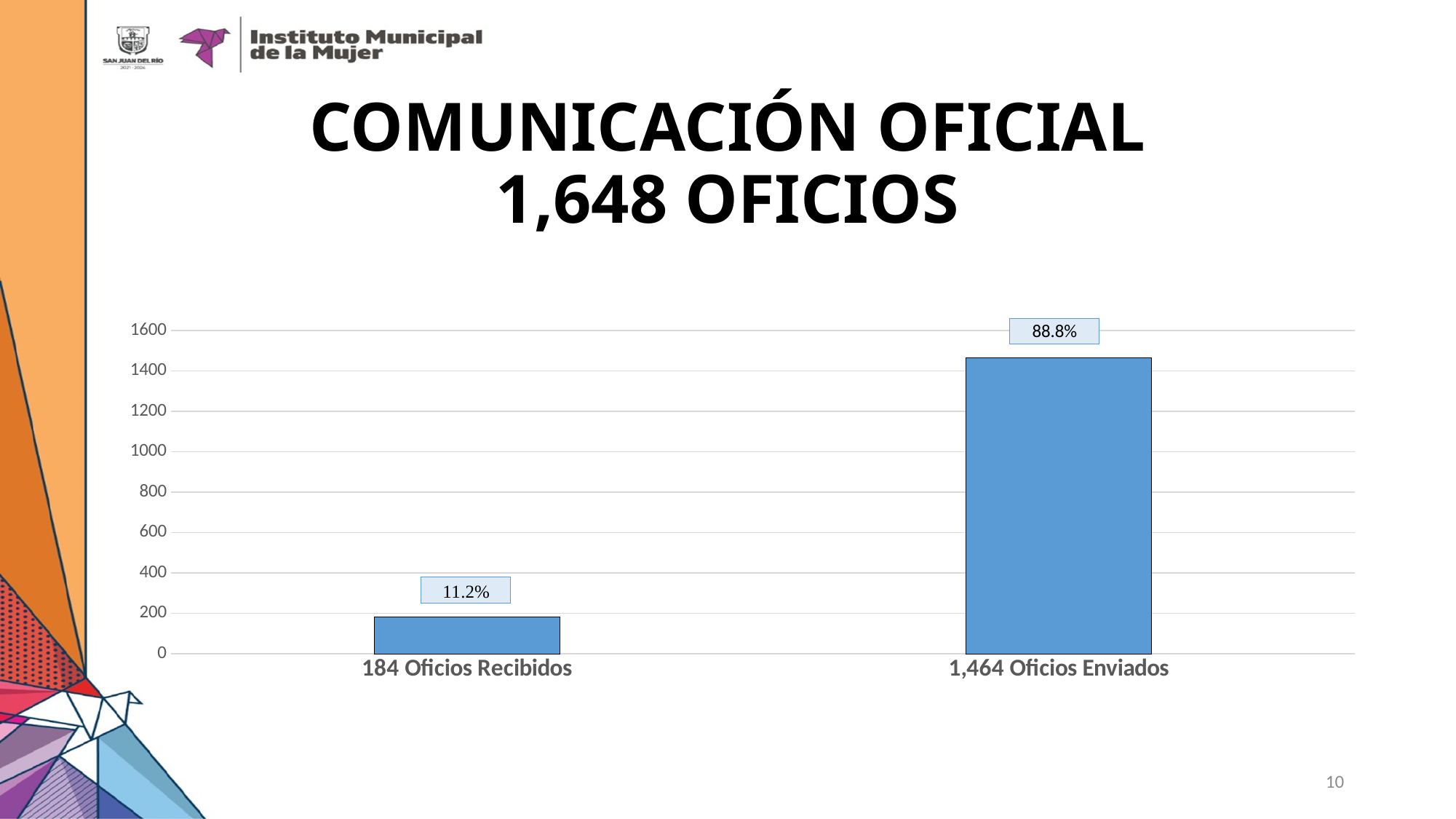
Which category has the shorter bar? 184 Oficios Recibidos What kind of chart is shown on the slide? bar chart How many bars does the chart show? 2 What percentage label is shown above the bar for Oficios Enviados? 88.8% Is the bar for Oficios Enviados greater or less than 1400? greater What percentage label is shown above the bar for Oficios Recibidos? 11.2% Is the bar for Oficios Recibidos greater or less than 200? less Which category has the taller bar? 1,464 Oficios Enviados What total number of oficios is stated in the slide title? 1,648 How many Oficios Enviados are stated in the category label? 1,464 What is the difference in percentage points between the Oficios Enviados label and the Oficios Recibidos label? 77.6 How many Oficios Recibidos are stated in the category label? 184